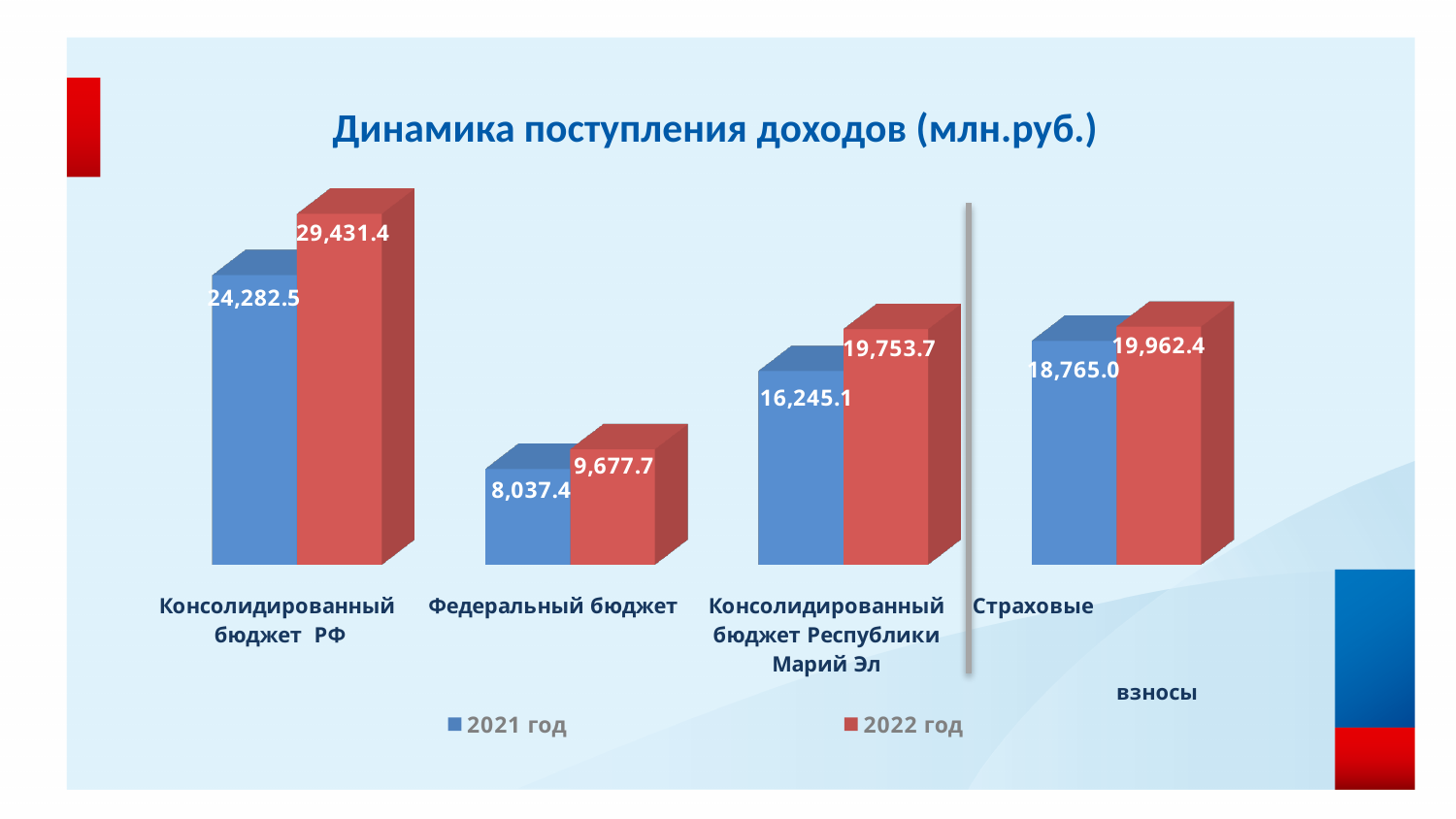
What kind of chart is shown on the slide? Bar chart What is the value for Консолидированный бюджет Республики Марий Эл in the 2022 год series? 19,753.7 What is the difference between the 2022 год and 2021 год values for Консолидированный бюджет Республики Марий Эл? 3,508.6 What is the value for Страховые взносы in the 2021 год series? 18,765.0 Which category has the highest value in the 2022 год series? Консолидированный бюджет РФ What is the value for Консолидированный бюджет РФ in the 2021 год series? 24,282.5 How many series does the legend list? 2 How many categories are shown on the x axis? 4 What is the value for Федеральный бюджет in the 2022 год series? 9,677.7 In the 2021 год series, which is larger: Страховые взносы or Консолидированный бюджет Республики Марий Эл? Страховые взносы Which category has the lowest value in the 2021 год series? Федеральный бюджет What is the difference between the 2022 год and 2021 год values for Консолидированный бюджет РФ? 5,148.9